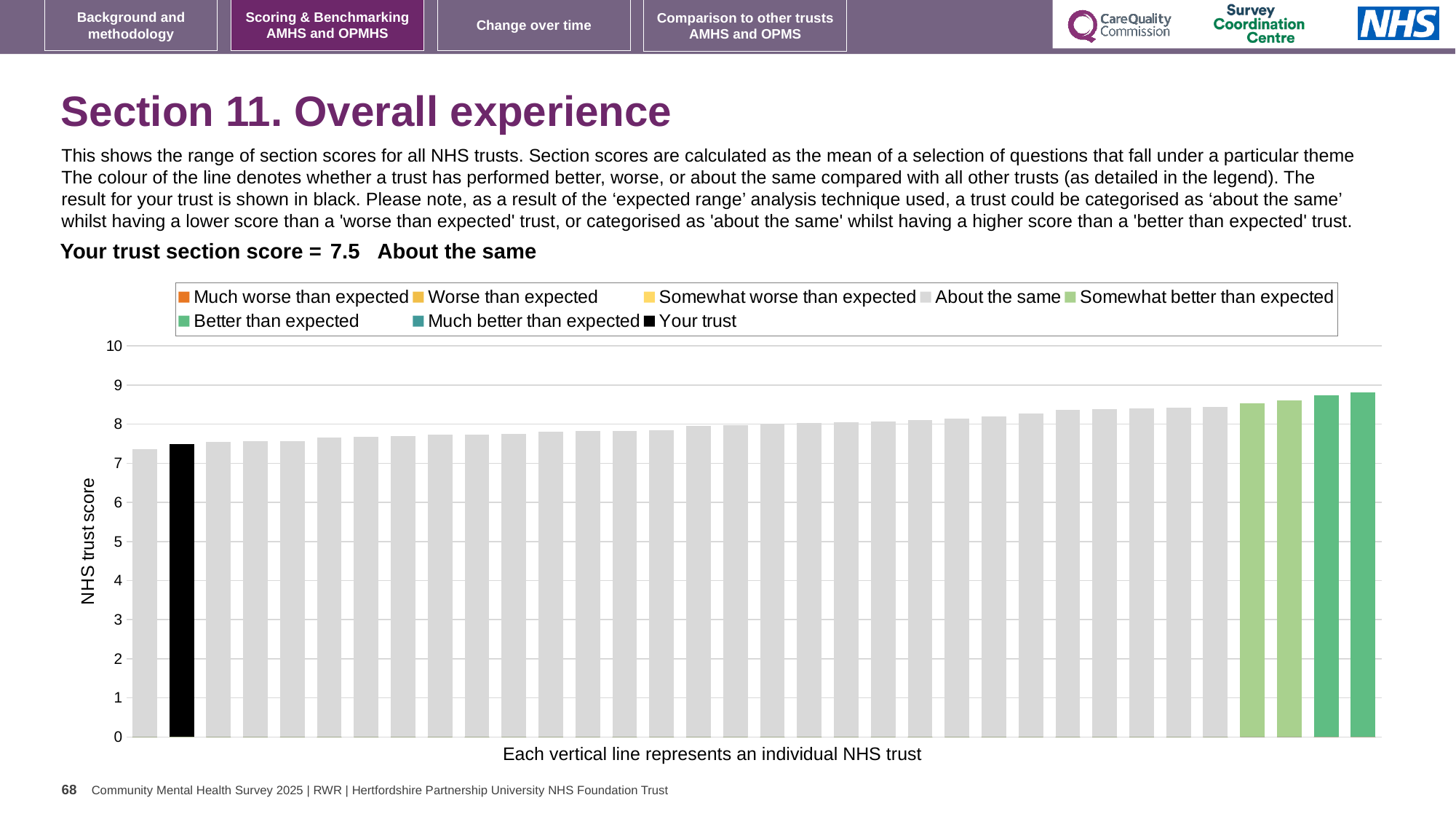
Is the value for the tallest bar greater or less than 8? greater How many bars are coloured green (somewhat better or better than expected)? 4 What is the label on the y axis? NHS trust score Is the value for your trust greater or less than 8? less How many entries does the chart legend list? 8 What is the section score for your trust? 7.5 What colour is the bar representing your trust? black Which category is your trust placed in for this section? About the same Is the value for the shortest bar greater or less than 7? greater Do the bar values rise or fall from left to right along the x axis? rise What kind of chart is shown on the slide? bar chart